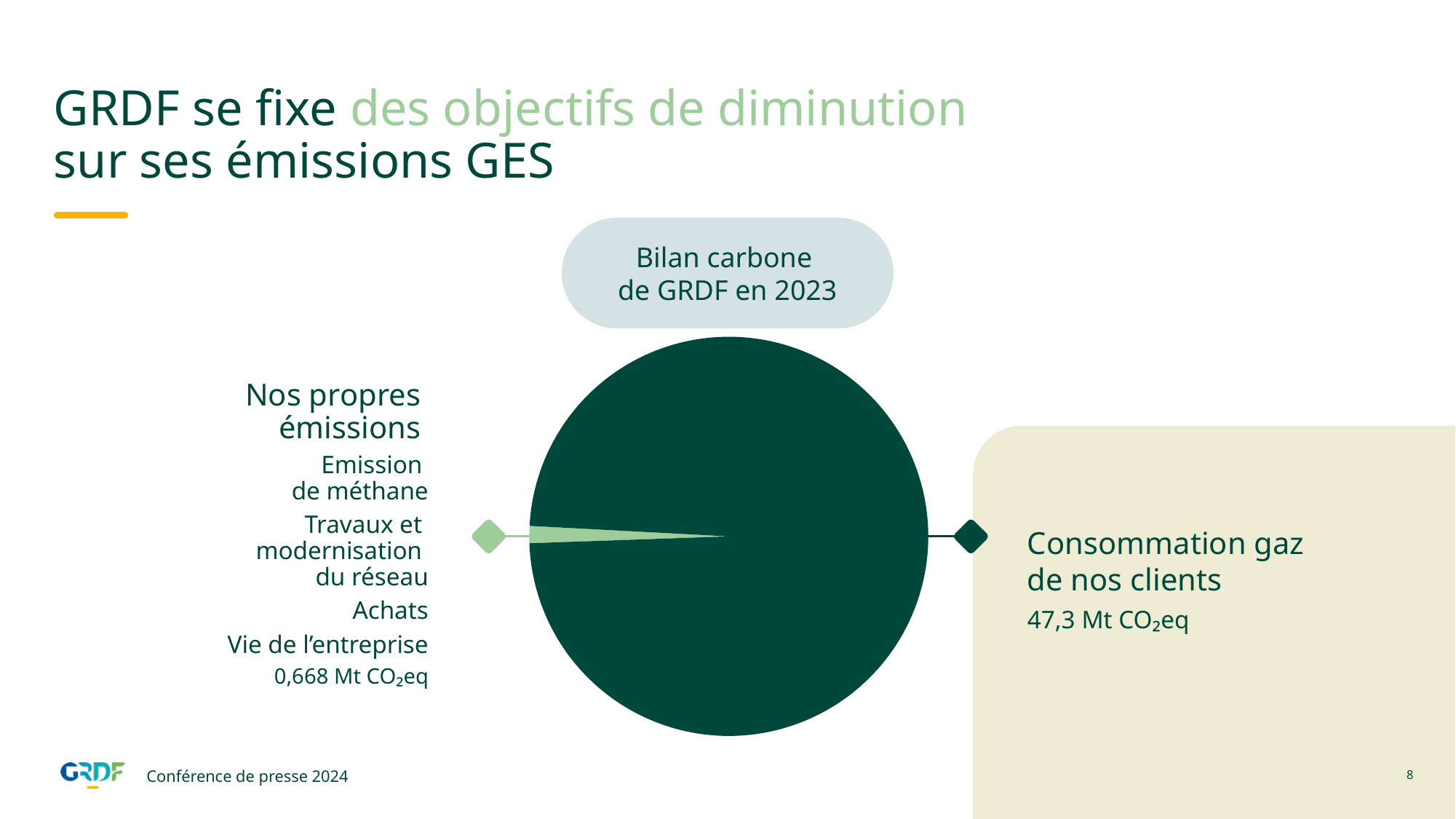
Which slice of the pie chart is the largest? Consommation gaz de nos clients What is the value for "Nos propres émissions"? 0,668 Mt CO₂eq What is the difference between "Consommation gaz de nos clients" and "Nos propres émissions"? 46,632 Mt CO₂eq What is the title of the pie chart? Bilan carbone de GRDF en 2023 Which slice of the pie chart is the smallest? Nos propres émissions How many slices does the pie chart have? 2 What kind of chart is shown on the slide? Pie chart What is the value for "Consommation gaz de nos clients"? 47,3 Mt CO₂eq Which is larger: "Nos propres émissions" or "Consommation gaz de nos clients"? Consommation gaz de nos clients Which slice is drawn in the light green colour? Nos propres émissions